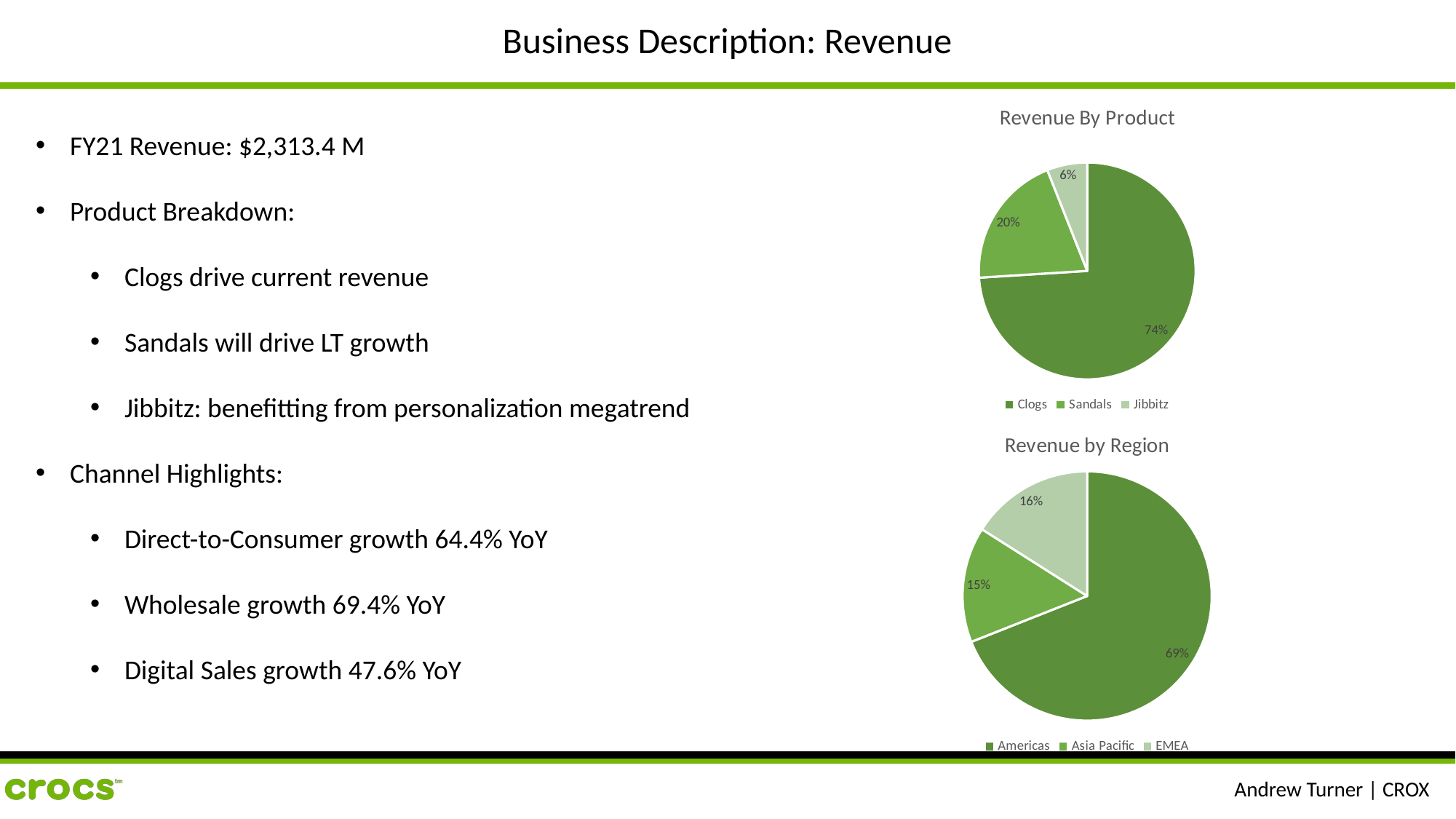
In the Revenue By Product chart, what share of revenue comes from Sandals? 20% In the Revenue by Region chart, what share of revenue comes from EMEA? 16% In the Revenue By Product chart, what share of revenue comes from Clogs? 74% How many entries does the legend of the Revenue By Product chart list? 3 What kind of chart is the Revenue by Region chart? Pie chart In the Revenue By Product chart, what share of revenue comes from Jibbitz? 6% In the Revenue by Region chart, what share of revenue comes from Asia Pacific? 15% In the Revenue By Product chart, which product has the largest share? Clogs In the Revenue by Region chart, which region has the largest share? Americas In the Revenue By Product chart, what is the difference in percentage points between Clogs and Sandals? 54 In the Revenue by Region chart, what share of revenue comes from the Americas? 69% In the Revenue By Product chart, which product has the smallest share? Jibbitz